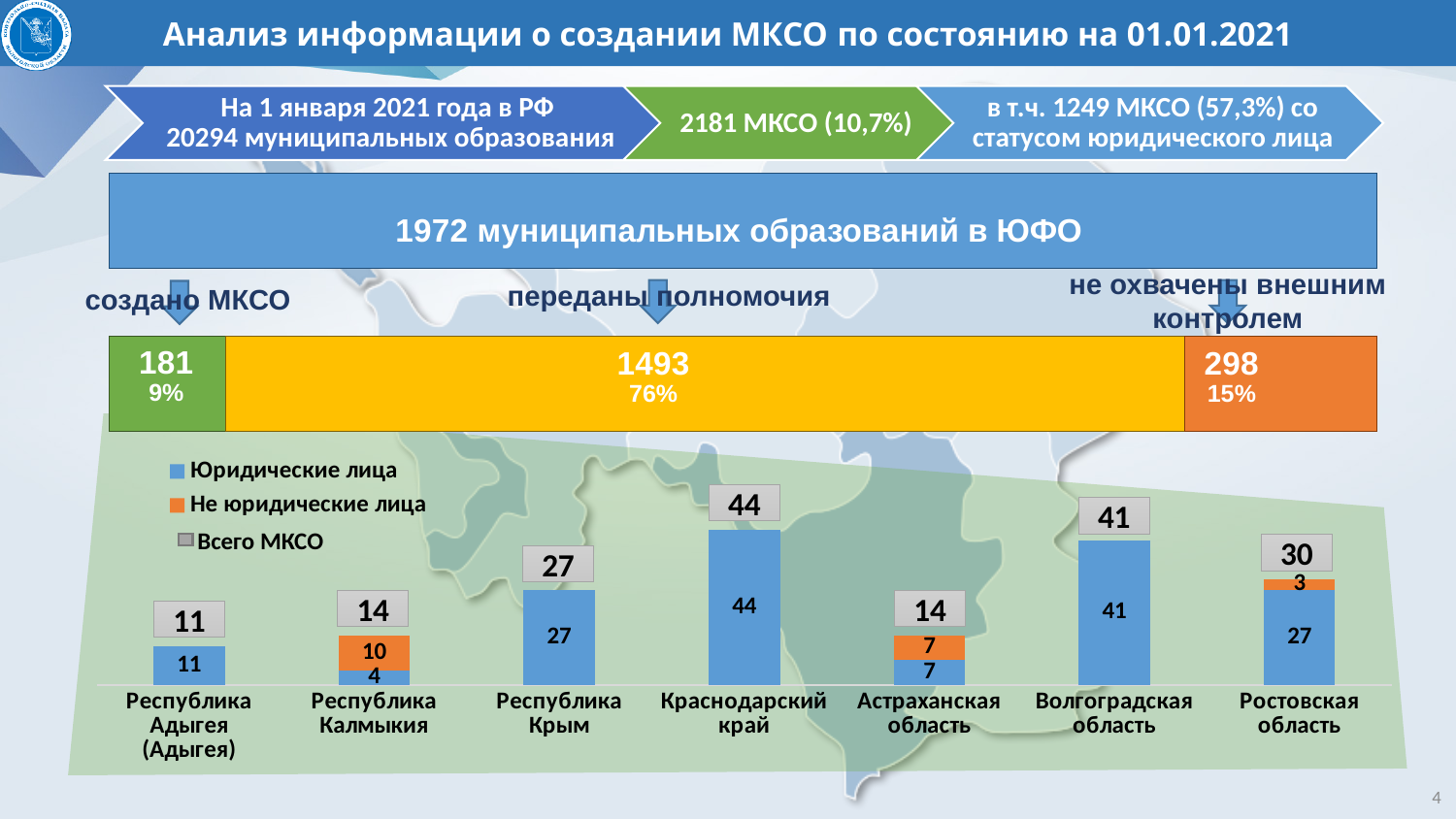
How many series does the legend of the bar chart list? 3 In the bar chart, which region has the highest Всего МКСО value? Краснодарский край In the bar chart, what is the Всего МКСО value for Ростовская область? 30 In the bar chart, what is the value for Юридические лица in Краснодарский край? 44 In the bar chart, what is the total of the stacked bar for Астраханская область? 14 In the bar chart, what is the difference between the Всего МКСО values for Краснодарский край and Волгоградская область? 3 In the bar chart, which is larger: the Юридические лица value for Астраханская область or for Республика Адыгея (Адыгея)? Республика Адыгея (Адыгея) In the bar chart, what is the value for Не юридические лица in Республика Калмыкия? 10 In the bar chart, which is larger: the Юридические лица value for Республика Крым or for Ростовская область? They are equal (27) In the bar chart, which region has the lowest Всего МКСО value? Республика Адыгея (Адыгея) How many regions are shown on the x axis of the bar chart? 7 What type of chart is shown at the bottom of the slide? Stacked bar chart